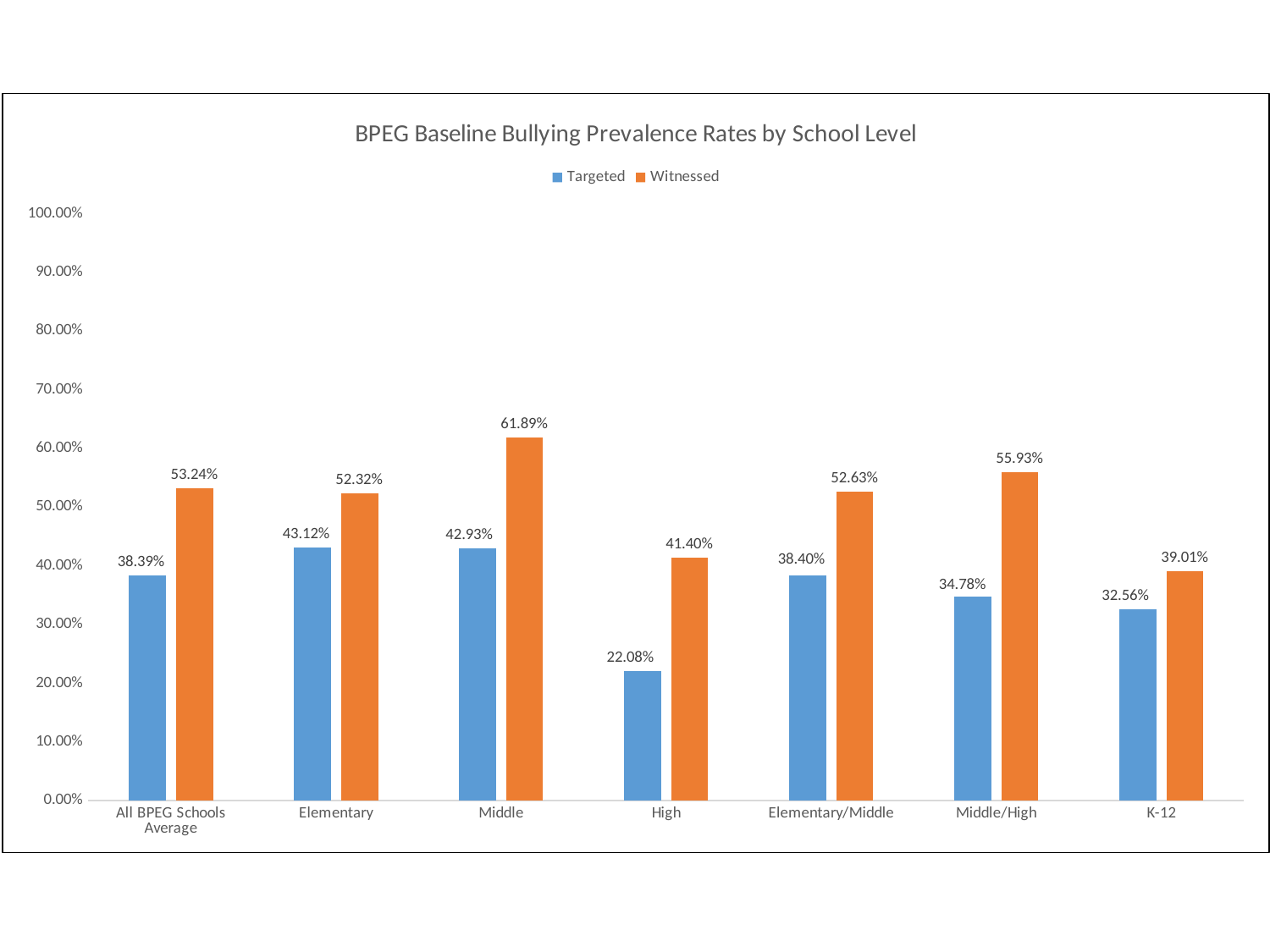
What is the difference between the Witnessed and Targeted values for Middle? 18.96% What is the title of the chart? BPEG Baseline Bullying Prevalence Rates by School Level Which school level has the lowest Targeted value? High What is the Witnessed value for Middle? 61.89% What is the Targeted value for High? 22.08% What is the difference between the Witnessed and Targeted values for High? 19.32% Which school level has the highest Witnessed value? Middle Which has the larger Witnessed value, Middle/High or Elementary/Middle? Middle/High What is the Witnessed value for K-12? 39.01% How many series does the legend list? 2 How many school level categories are shown on the x axis? 7 What kind of chart is shown on the slide? Bar chart